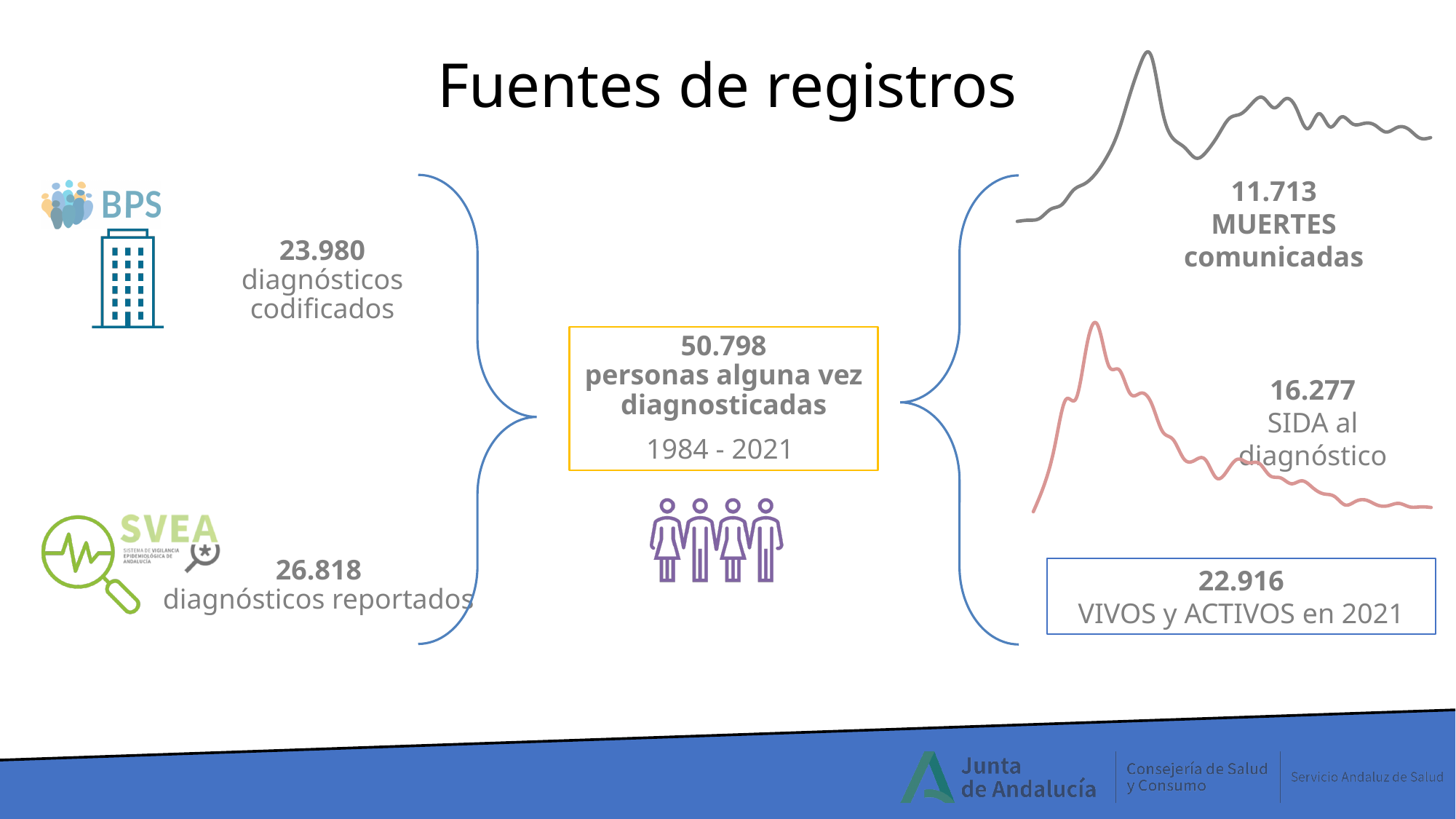
What colour is the line in the chart next to '11.713 MUERTES comunicadas'? grey How many line charts are shown on the slide? 2 What kind of chart is the grey chart at the top right of the slide, next to '11.713 MUERTES comunicadas'? line chart In the red line chart next to '16.277 SIDA al diagnóstico', is the value at the right end higher or lower than the value at the peak? lower In the red line chart next to '16.277 SIDA al diagnóstico', do the values rise or fall after the peak near the left? fall What kind of chart is the red chart on the right of the slide, next to '16.277 SIDA al diagnóstico'? line chart What colour is the line in the chart next to '16.277 SIDA al diagnóstico'? red In the grey line chart next to '11.713 MUERTES comunicadas', is the value at the right end higher or lower than the tallest peak? lower In the grey line chart next to '11.713 MUERTES comunicadas', do the values rise or fall from the left end up to the tallest peak? rise